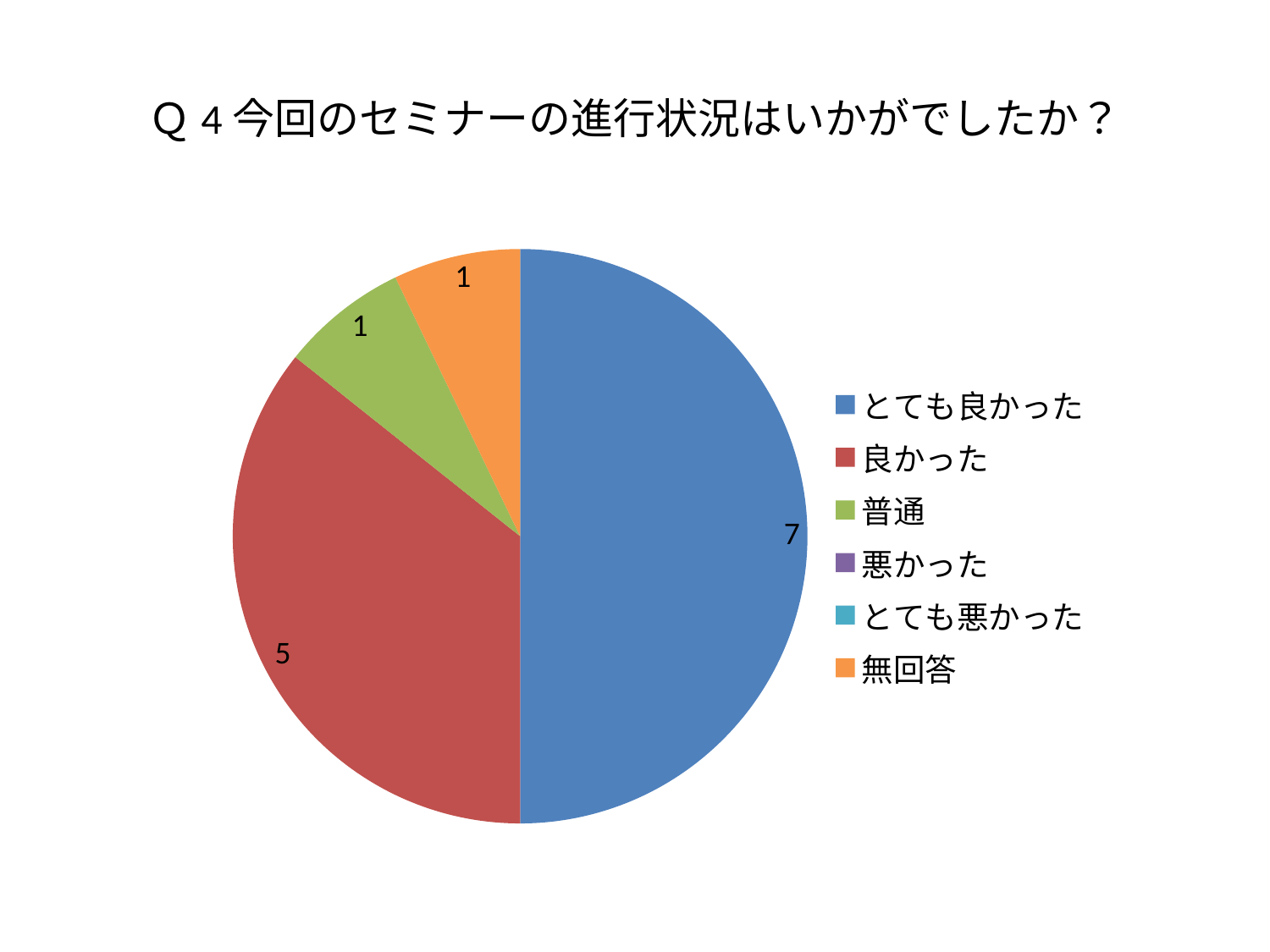
What share of the pie does とても良かった represent? 50% What is the total of all the values shown on the pie chart? 14 Which is larger, the value for 良かった or the value for 普通? 良かった What is the difference between the values for とても良かった and 良かった? 2 How many entries does the legend list? 6 What kind of chart is shown on the slide? pie chart What is the value for 普通? 1 What is the title of the chart? Q４今回のセミナーの進行状況はいかがでしたか？ What is the value for 無回答? 1 What is the value for とても良かった? 7 Which category has the largest slice of the pie? とても良かった What is the value for 良かった? 5